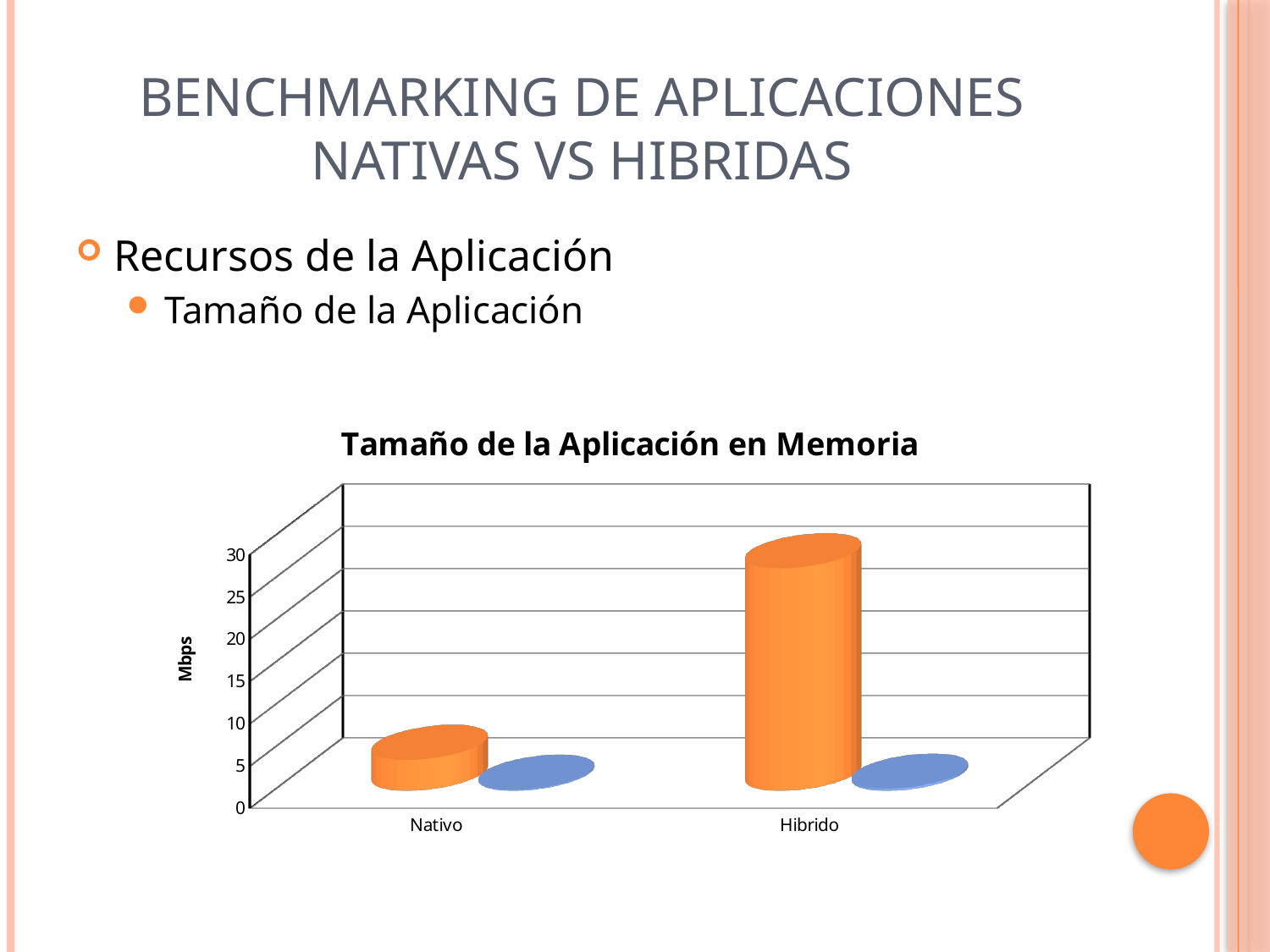
What label is shown on the vertical axis of the chart? Mbps Which category has the shortest orange bar in the chart? Nativo What is the title of the chart? Tamaño de la Aplicación en Memoria Which has a larger orange bar, Nativo or Hibrido? Hibrido How many categories are shown on the x axis of the chart? 2 Which category has the tallest orange bar in the chart? Hibrido Do the orange bars rise or fall from Nativo to Hibrido? rise What kind of chart is shown on the slide? bar chart Is the orange bar for Nativo greater or less than 10? less What is the highest value shown on the vertical axis of the chart? 30 Is the orange bar for Hibrido greater or less than 20? greater